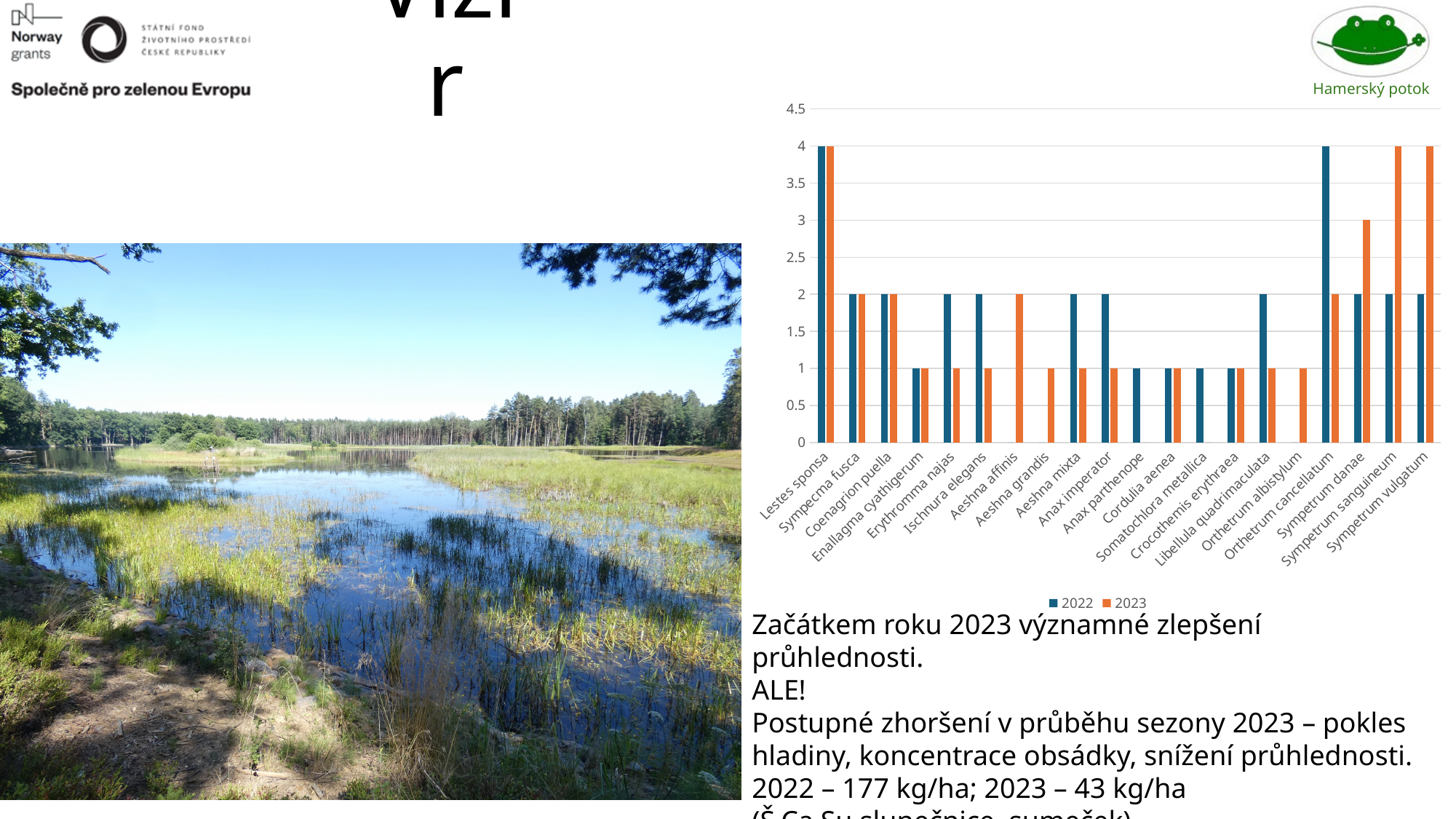
What is the difference between the 2022 and 2023 values for Orthetrum cancellatum? 2 Which two series are listed in the chart legend? 2022 and 2023 Is the 2023 value for Sympetrum vulgatum greater or less than 3? greater What is the 2023 value for Sympetrum danae? 3 How many species categories are shown on the x axis of the chart? 20 How many series does the chart legend list? 2 What is the 2022 value for Orthetrum cancellatum? 4 For Sympetrum sanguineum, which year has the larger value, 2022 or 2023? 2023 What is the 2022 value for Erythromma najas? 2 What is the 2023 value for Lestes sponsa? 4 What kind of chart is shown on the slide? bar chart Which species has the highest 2022 value together with Lestes sponsa? Orthetrum cancellatum